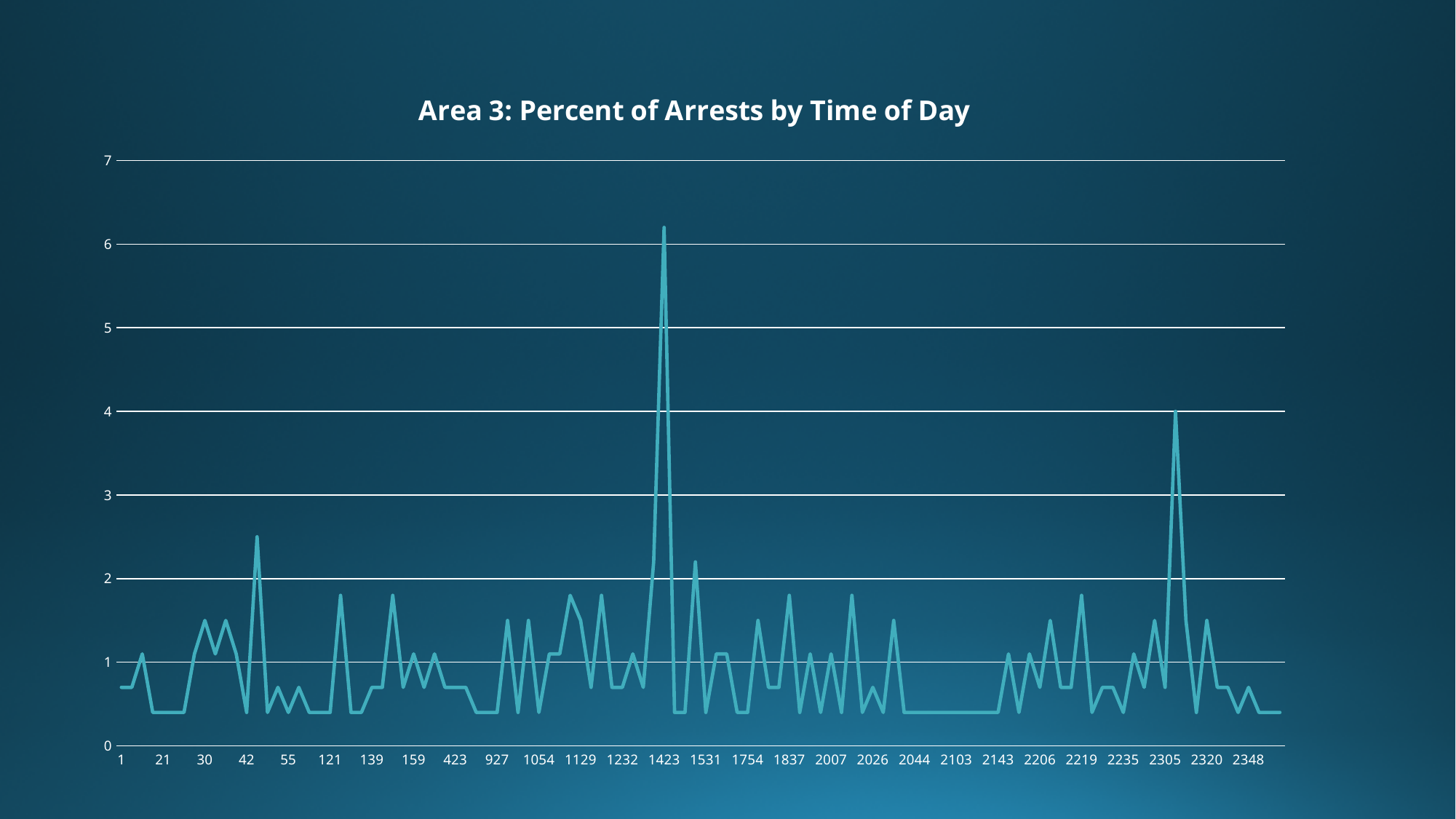
Which has the larger value, 2305 or 2103? 2305 Is the value for 1 greater or less than 1? less Is the value for 1423 greater or less than 5? greater Is the value for 2044 greater or less than 1? less What is the title of the chart? Area 3: Percent of Arrests by Time of Day Which labeled time of day has the highest percent of arrests? 1423 What kind of chart is shown on the slide? line chart Which has the larger value, 1423 or 2305? 1423 What is the highest value shown on the vertical axis? 7